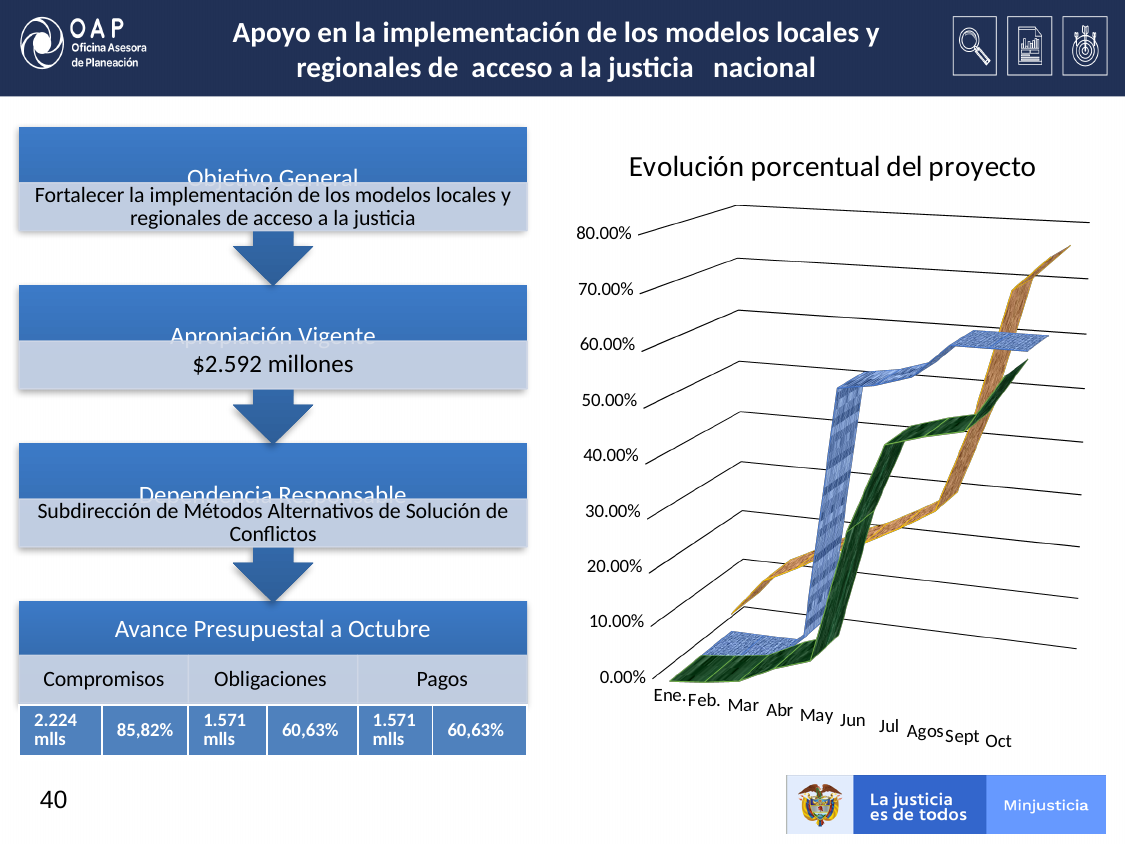
In the "Evolución porcentual del proyecto" chart, which month is the first category on the x axis? Ene. What is the highest value shown on the vertical axis of the "Evolución porcentual del proyecto" chart? 80.00% What kind of chart is "Evolución porcentual del proyecto"? line chart How many months are shown on the x axis of the "Evolución porcentual del proyecto" chart? 10 In the "Evolución porcentual del proyecto" chart, do the values generally rise or fall from Ene. to Oct? rise What is the title of the chart on the right side of the slide? Evolución porcentual del proyecto In the "Evolución porcentual del proyecto" chart, which month is the last category on the x axis? Oct